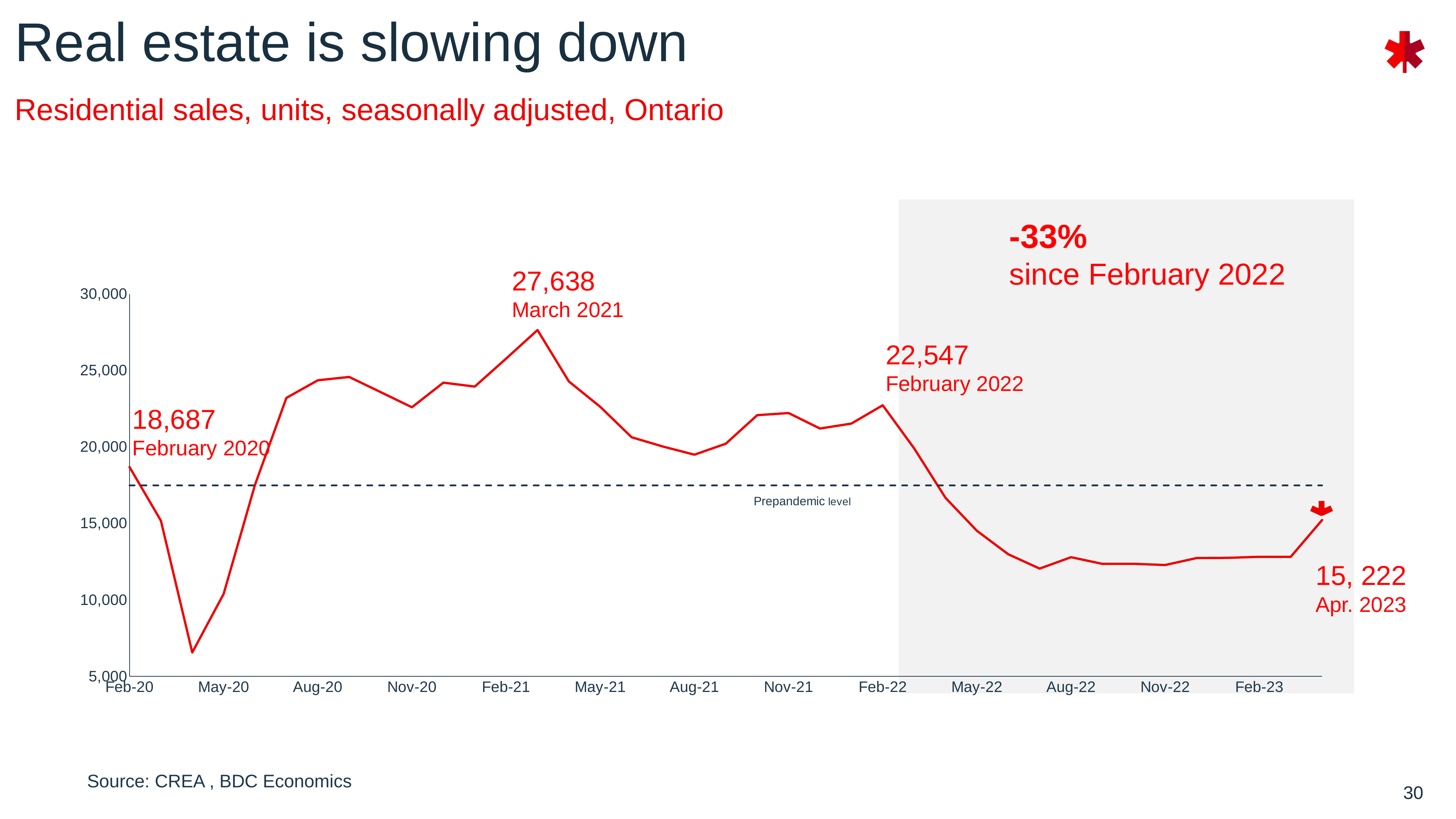
What was the value of residential sales in February 2022? 22,547 Which labelled month has the highest residential sales value? March 2021 What is the difference between the February 2022 value and the February 2020 value? 3,860 What is the difference between the March 2021 value and the February 2022 value? 5,091 What was the value of residential sales in March 2021? 27,638 Which is larger, the value for February 2020 or the value for February 2022? February 2022 What does the dashed horizontal line on the chart represent? Prepandemic level What type of chart is shown on the slide? Line chart What value is labelled for April 2023? 15, 222 What was the value of residential sales in February 2020? 18,687 What percentage change since February 2022 is annotated on the chart? -33%